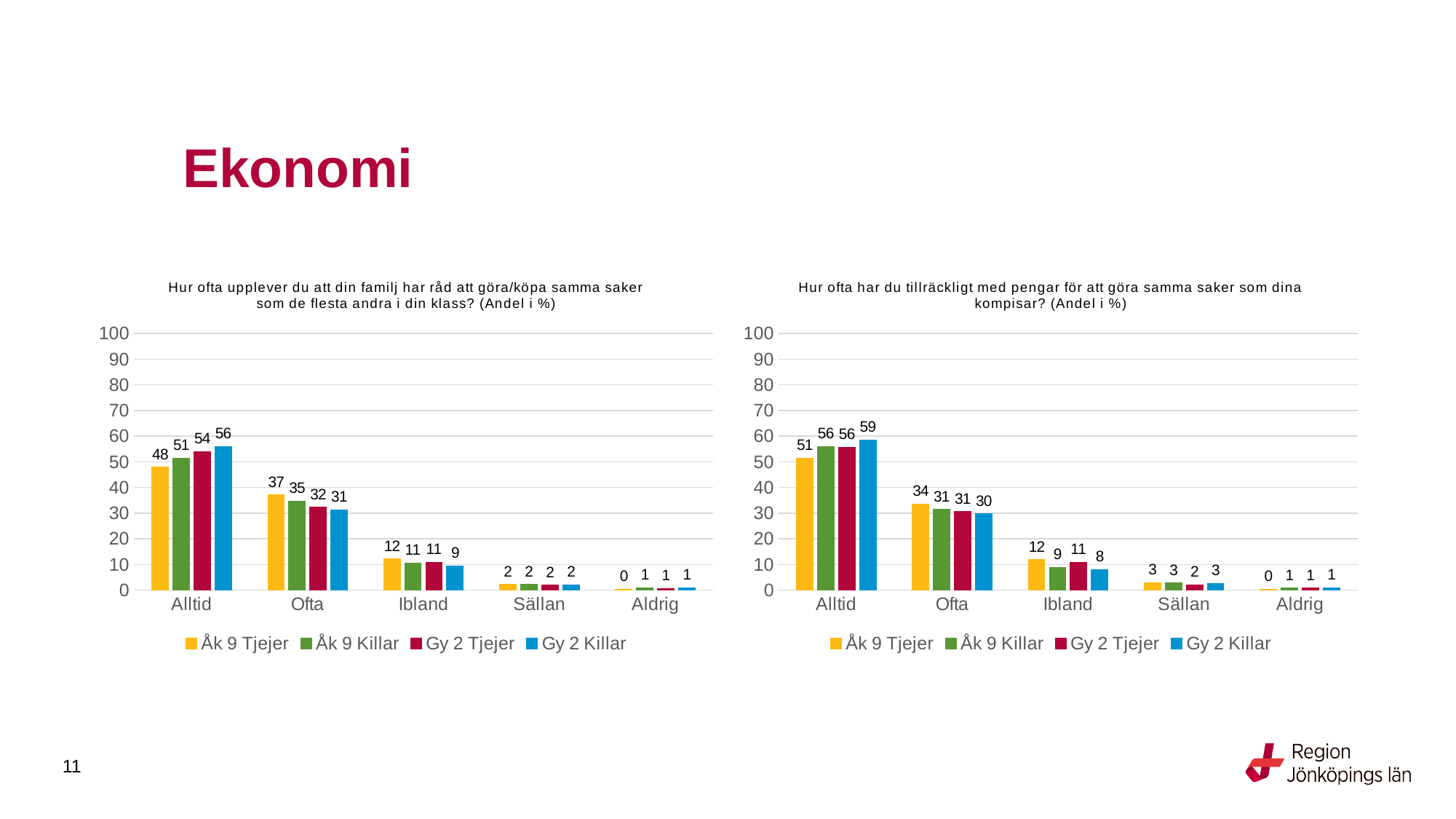
In the left chart (family affording the same things as classmates), what is the value for Gy 2 Killar in the Alltid category? 56 In the left chart, what is the difference between Gy 2 Killar and Åk 9 Tjejer in the Alltid category? 8 What kind of chart is the left chart? Bar chart In the right chart, do the values for Gy 2 Tjejer rise or fall from Alltid to Aldrig? Fall In the right chart, what is the difference between Åk 9 Tjejer and Gy 2 Killar in the Ofta category? 4 In the left chart, which series has the highest value in the Ofta category? Åk 9 Tjejer How many categories are shown on the x axis of the left chart? 5 In the right chart, which series has the lowest value in the Ibland category? Gy 2 Killar How many series does the legend of the right chart list? 4 In the left chart, is the value for Åk 9 Tjejer in the Alltid category greater or less than 40? greater In the right chart (enough money to do the same things as friends), what is the value for Åk 9 Tjejer in the Ofta category? 34 In the right chart, which is larger in the Alltid category: Gy 2 Killar or Åk 9 Tjejer? Gy 2 Killar